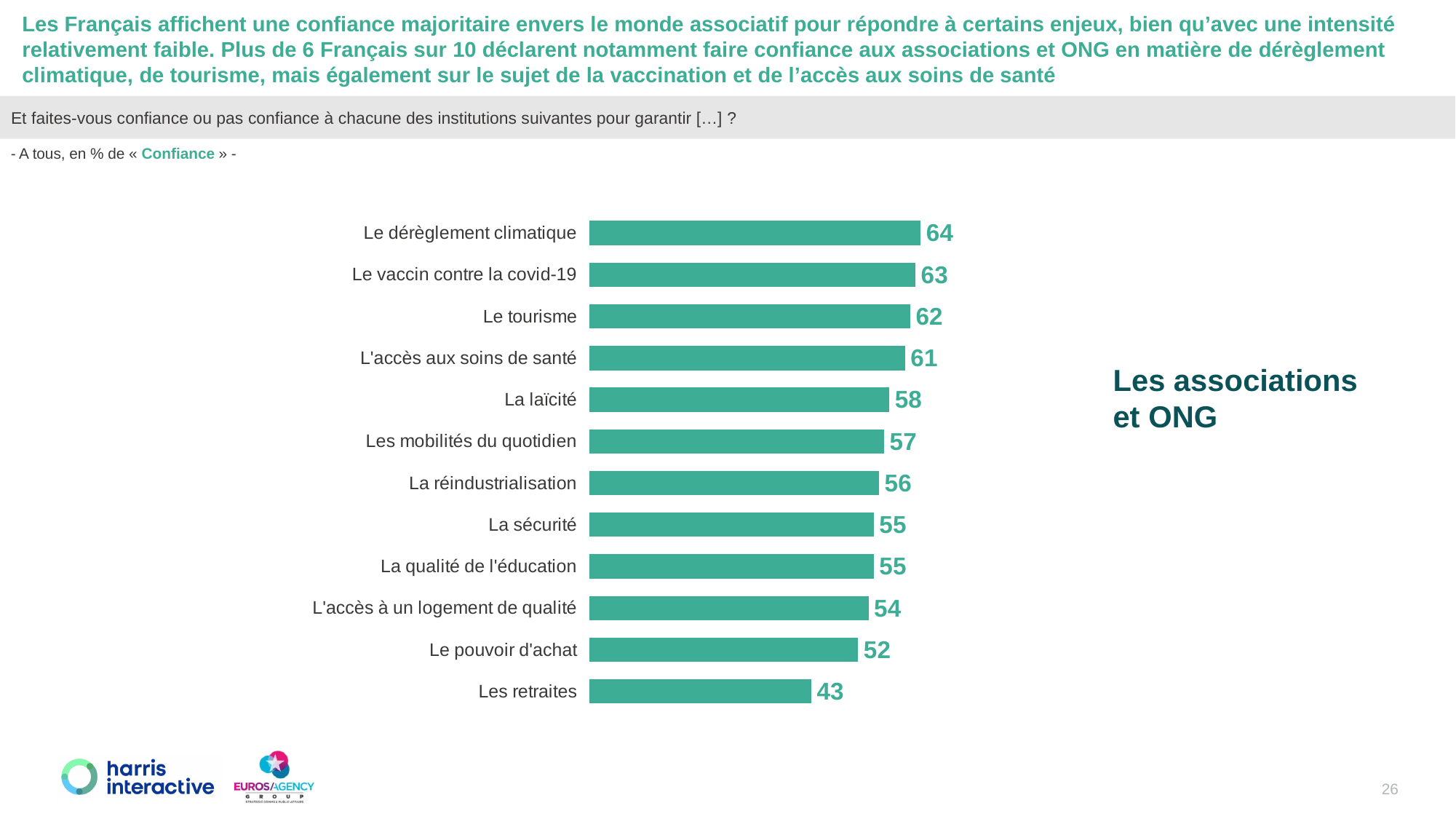
How many categories are shown in the chart? 12 Which category has the lowest value? Les retraites Do the values rise or fall going from the top bar to the bottom bar? Fall What is the value for "La laïcité"? 58 Which has a larger value, "Le vaccin contre la covid-19" or "La réindustrialisation"? Le vaccin contre la covid-19 What kind of chart is shown on the slide? Bar chart What is the difference between the values for "Le tourisme" and "Le pouvoir d'achat"? 10 What is the value for "Les retraites"? 43 Which institution does the chart refer to, according to the label on the right? Les associations et ONG What is the difference between the values for "Le dérèglement climatique" and "Les retraites"? 21 What is the value for "Le dérèglement climatique"? 64 Which category has the highest value? Le dérèglement climatique